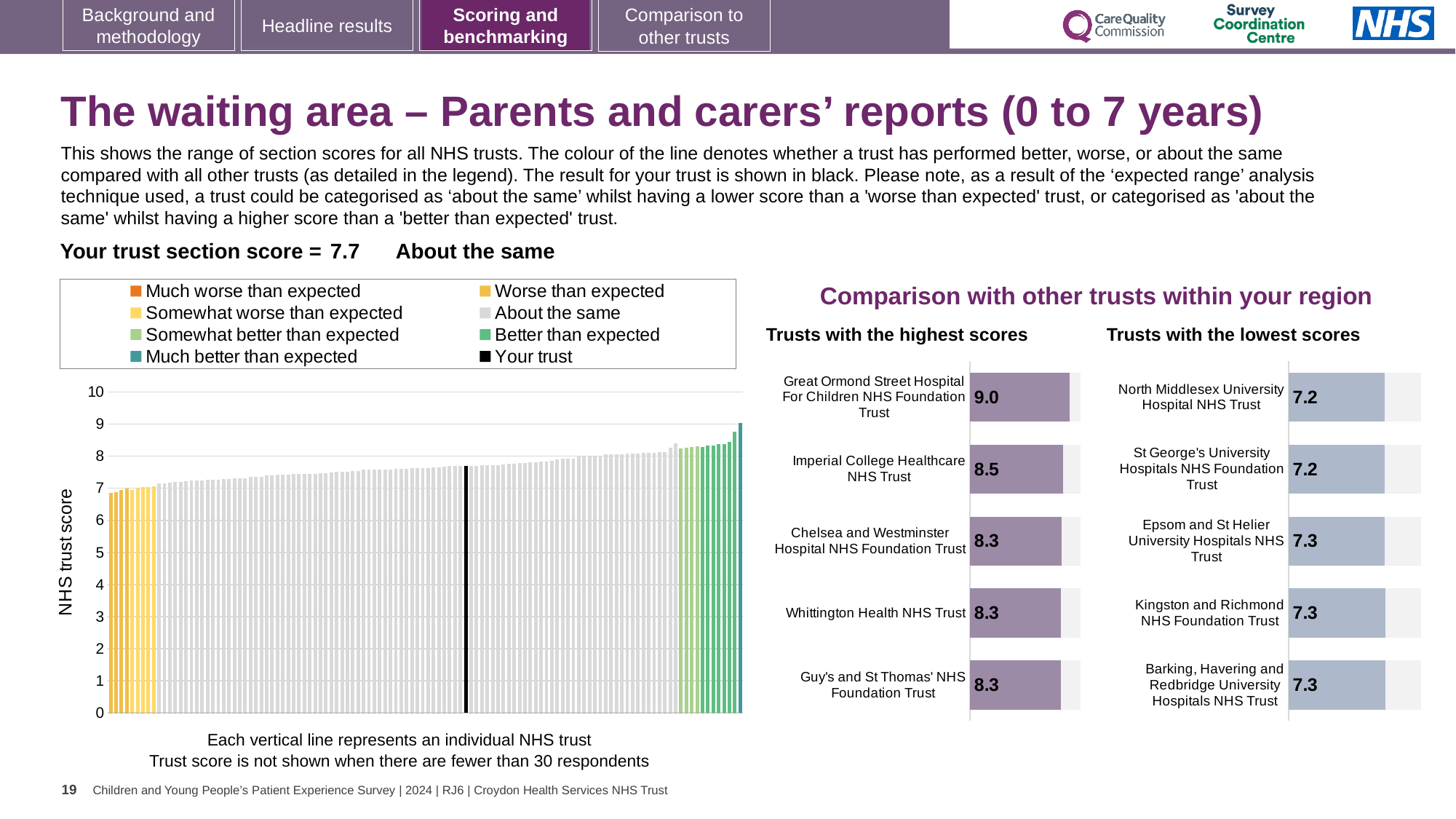
In the 'Trusts with the highest scores' chart, what is the score for Great Ormond Street Hospital For Children NHS Foundation Trust? 9.0 In the 'Trusts with the highest scores' chart, what is the score for Imperial College Healthcare NHS Trust? 8.5 In the NHS trust score chart, do the bar values rise or fall from left to right? Rise In the 'Trusts with the lowest scores' chart, what is the score for Epsom and St Helier University Hospitals NHS Trust? 7.3 How many entries does the legend of the NHS trust score chart list? 8 In the NHS trust score chart, is the value of the black 'Your trust' bar greater or less than 7? greater How many trusts are shown in the 'Trusts with the lowest scores' chart? 5 What kind of chart is the NHS trust score chart on the left of the slide? Bar chart Which is larger: the score for Great Ormond Street Hospital For Children NHS Foundation Trust in the highest scores chart, or the score for North Middlesex University Hospital NHS Trust in the lowest scores chart? Great Ormond Street Hospital For Children NHS Foundation Trust In the 'Trusts with the lowest scores' chart, what is the score for North Middlesex University Hospital NHS Trust? 7.2 In the 'Trusts with the highest scores' chart, which trust has the highest score? Great Ormond Street Hospital For Children NHS Foundation Trust In the 'Trusts with the highest scores' chart, what is the difference between the scores of Great Ormond Street Hospital For Children NHS Foundation Trust and Imperial College Healthcare NHS Trust? 0.5